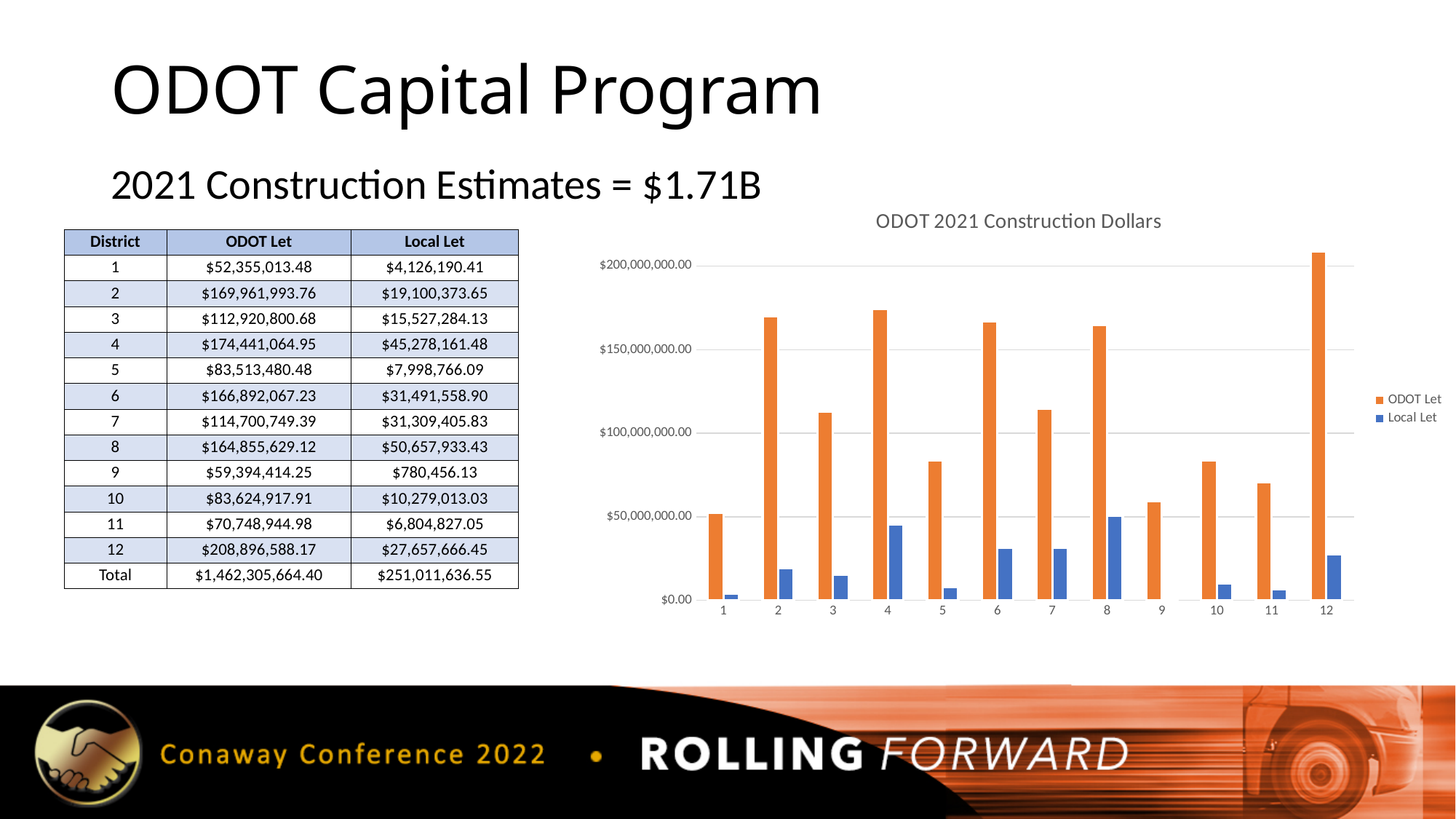
What is the Local Let value for district 8, as shown in the table on the slide? $50,657,933.43 Which district has the lowest Local Let value in the ODOT 2021 Construction Dollars chart? 9 In the ODOT 2021 Construction Dollars chart, which district has the larger ODOT Let value, district 10 or district 11? 10 Which district has the lowest ODOT Let value in the ODOT 2021 Construction Dollars chart? 1 In the ODOT 2021 Construction Dollars chart, is the ODOT Let value for district 5 greater or less than $100,000,000.00? less What is the ODOT Let value for district 12, as shown in the table on the slide? $208,896,588.17 How many series does the legend of the ODOT 2021 Construction Dollars chart list? 2 How many districts are plotted along the x axis of the ODOT 2021 Construction Dollars chart? 12 Which district has the highest ODOT Let value in the ODOT 2021 Construction Dollars chart? 12 In the ODOT 2021 Construction Dollars chart, is the ODOT Let value for district 12 greater or less than $200,000,000.00? greater What type of chart is the ODOT 2021 Construction Dollars chart? bar chart What colour are the ODOT Let bars in the ODOT 2021 Construction Dollars chart? orange